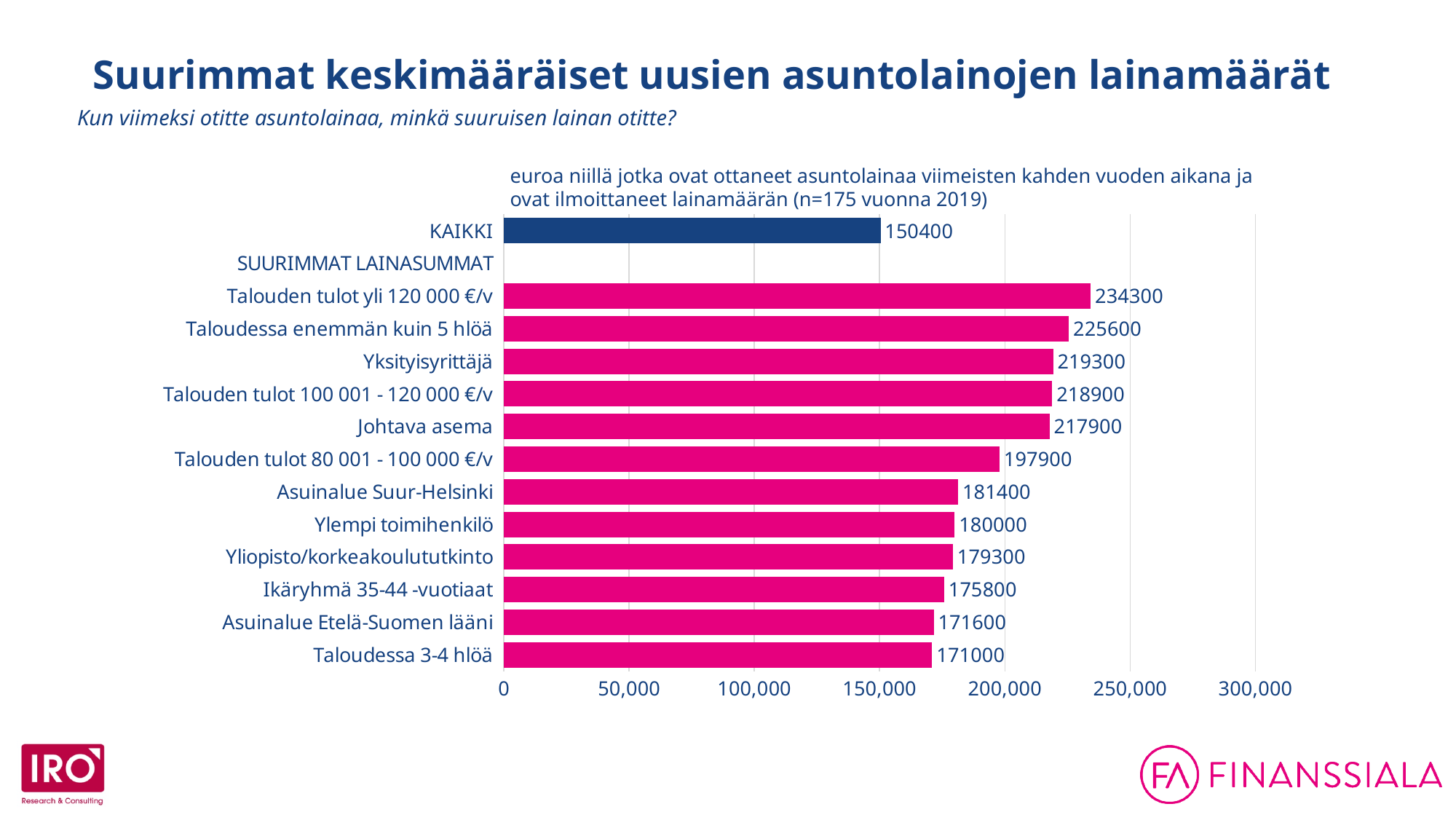
What is the value for Asuinalue Etelä-Suomen lääni? 171600 What is the value for Johtava asema? 217900 What kind of chart is shown on the slide? bar chart What is the difference between the values for Asuinalue Suur-Helsinki and Taloudessa 3-4 hlöä? 10400 Which category has the highest value? Talouden tulot yli 120 000 €/v What is the value for KAIKKI? 150400 How many bars are plotted in the chart? 13 Which category has the lowest value? KAIKKI Which is larger, the value for Taloudessa enemmän kuin 5 hlöä or the value for Ylempi toimihenkilö? Taloudessa enemmän kuin 5 hlöä Is the value for Talouden tulot 80 001 - 100 000 €/v greater or less than 200,000? less What is the difference between the values for Talouden tulot yli 120 000 €/v and KAIKKI? 83900 What is the value for Talouden tulot yli 120 000 €/v? 234300